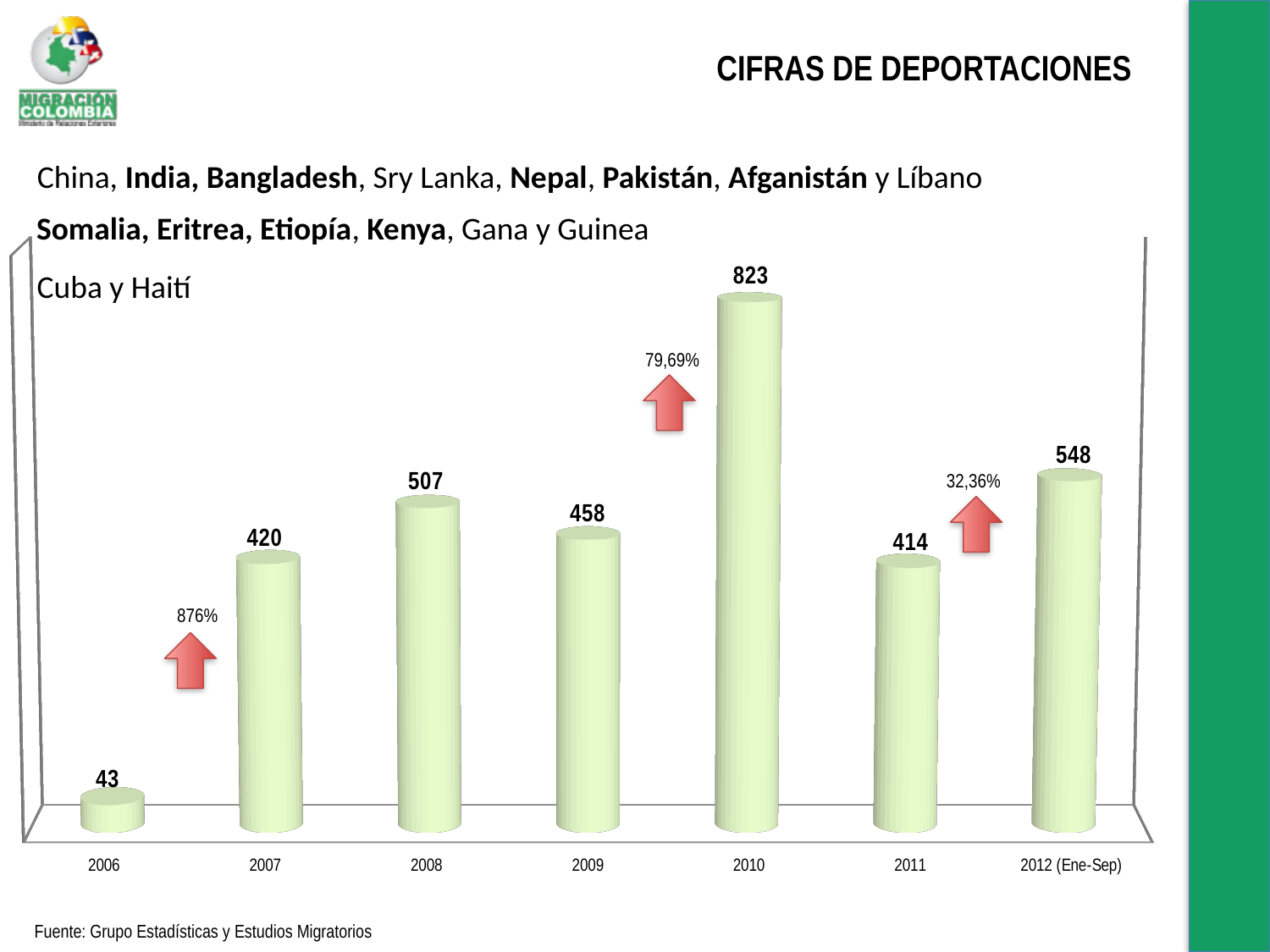
What is the value for 2012 (Ene-Sep)? 548 What is the title of the slide? CIFRAS DE DEPORTACIONES What is the value for 2010? 823 How many years are shown on the x axis? 7 Which year has the highest value? 2010 What is the value for 2006? 43 What is the difference between the values for 2008 and 2009? 49 What is the difference between the values for 2010 and 2011? 409 What percentage increase is shown between 2009 and 2010? 79,69% What kind of chart is this? bar chart Which is larger, the value for 2007 or the value for 2011? 2007 Which year has the lowest value? 2006